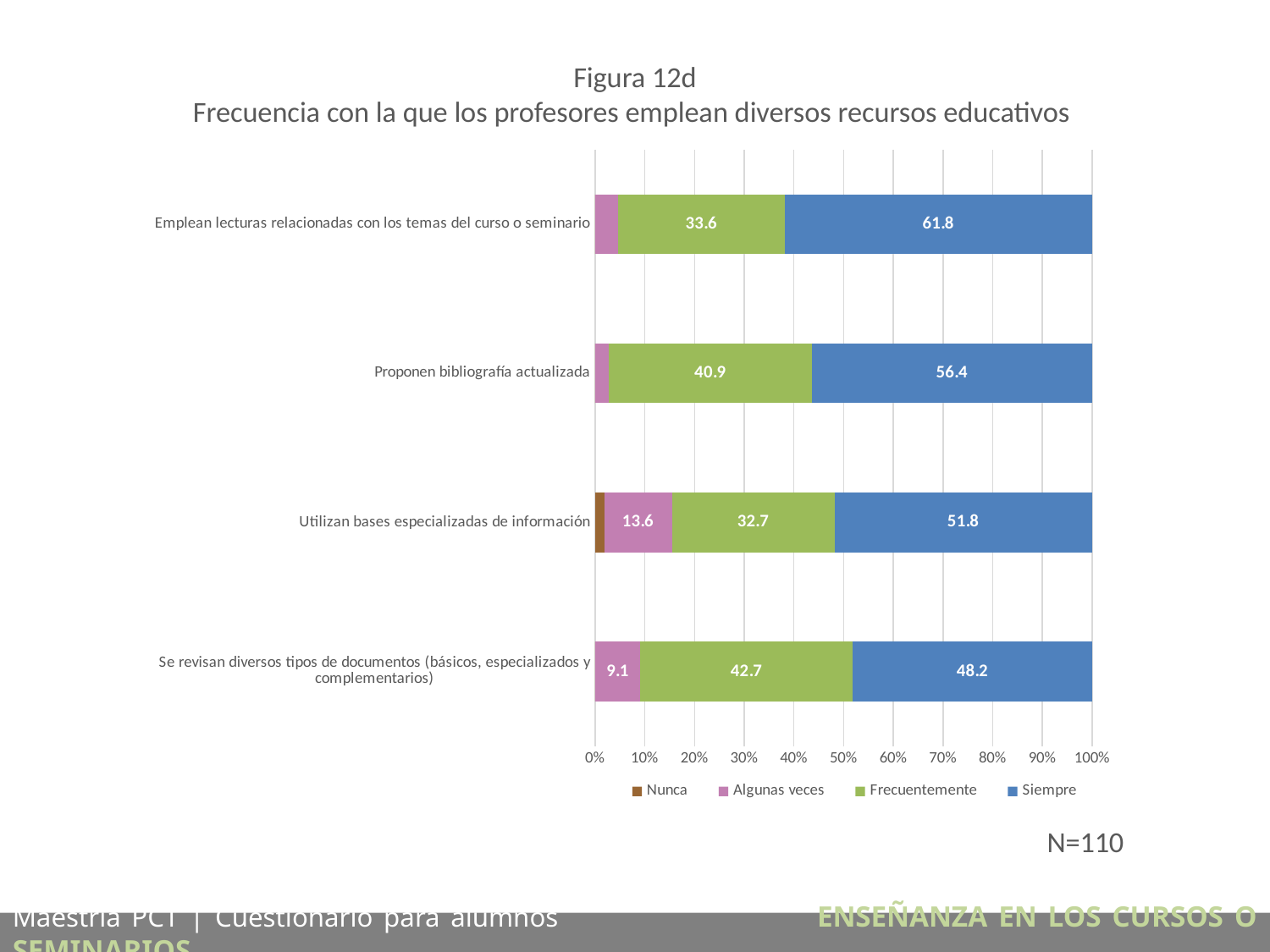
What is the value for Algunas veces in the category "Se revisan diversos tipos de documentos (básicos, especializados y complementarios)"? 9.1 Which category has the lowest value for Siempre? Se revisan diversos tipos de documentos (básicos, especializados y complementarios) Which has a larger Siempre value: "Proponen bibliografía actualizada" or "Utilizan bases especializadas de información"? Proponen bibliografía actualizada How many categories are shown in the chart? 4 What kind of chart is shown on the slide? Stacked bar chart What is the value for Frecuentemente in the category "Proponen bibliografía actualizada"? 40.9 What is the value for Algunas veces in the category "Utilizan bases especializadas de información"? 13.6 How many series does the legend list? 4 Which category has the highest value for Siempre? Emplean lecturas relacionadas con los temas del curso o seminario What is the value for Siempre in the category "Emplean lecturas relacionadas con los temas del curso o seminario"? 61.8 Is the Algunas veces value for "Emplean lecturas relacionadas con los temas del curso o seminario" greater or less than 10%? less What is the difference between the Siempre values for "Emplean lecturas relacionadas con los temas del curso o seminario" and "Se revisan diversos tipos de documentos (básicos, especializados y complementarios)"? 13.6